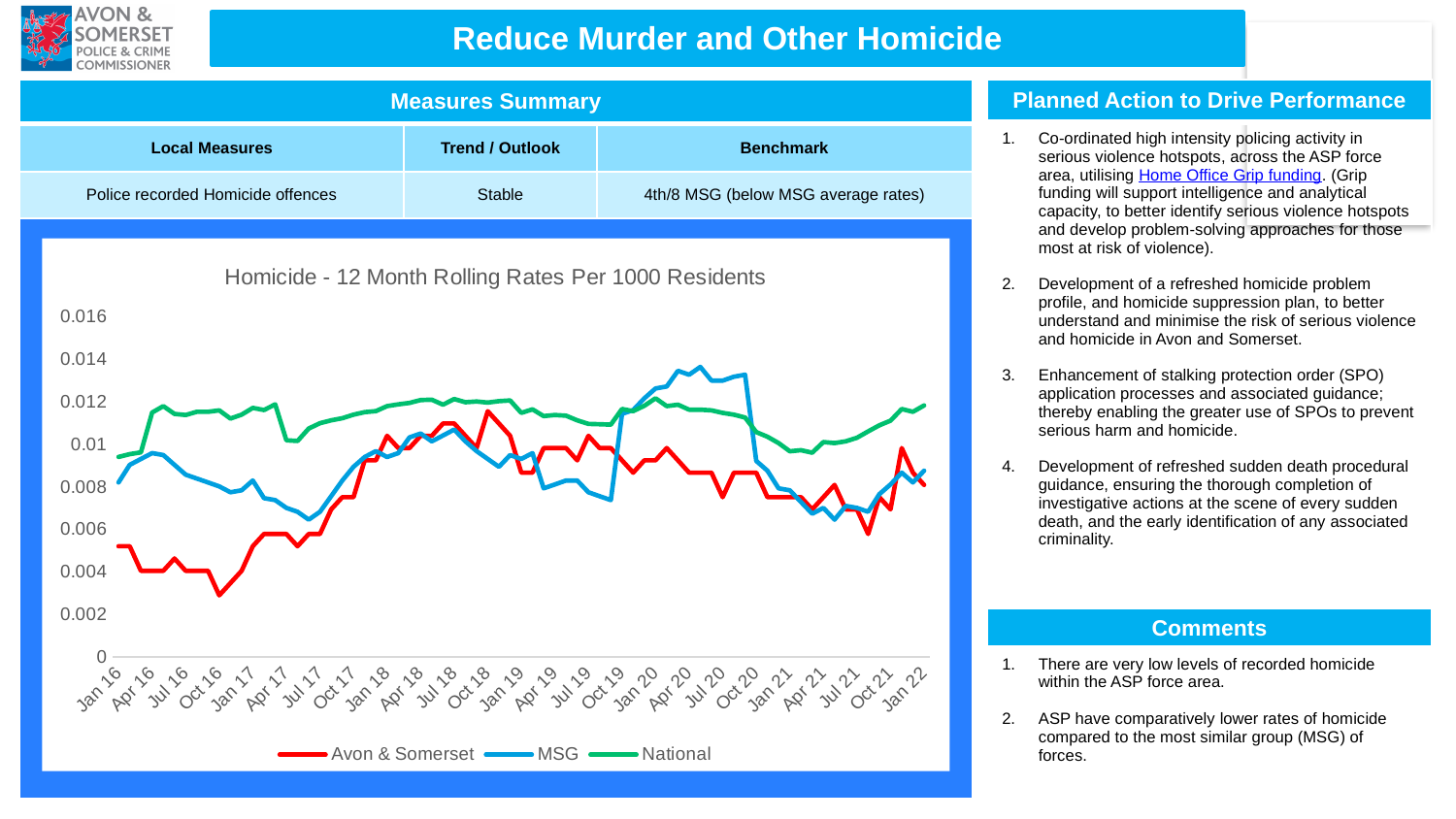
What kind of chart is shown on the slide? Line chart Is the value for Avon & Somerset at Jan 16 greater or less than 0.004? greater Which series has the lowest value at Jan 16? Avon & Somerset How many series does the chart legend list? 3 What is the title of the chart? Homicide - 12 Month Rolling Rates Per 1000 Residents Which series has the highest value at Apr 20? MSG Is the value for National at Jan 22 greater or less than 0.01? greater Is the value for Avon & Somerset at Oct 16 greater or less than 0.004? less At Jan 16, which series has the higher value, National or Avon & Somerset? National Does the Avon & Somerset line rise or fall between Oct 16 and Jan 18? Rise Which series is drawn in green in the chart? National